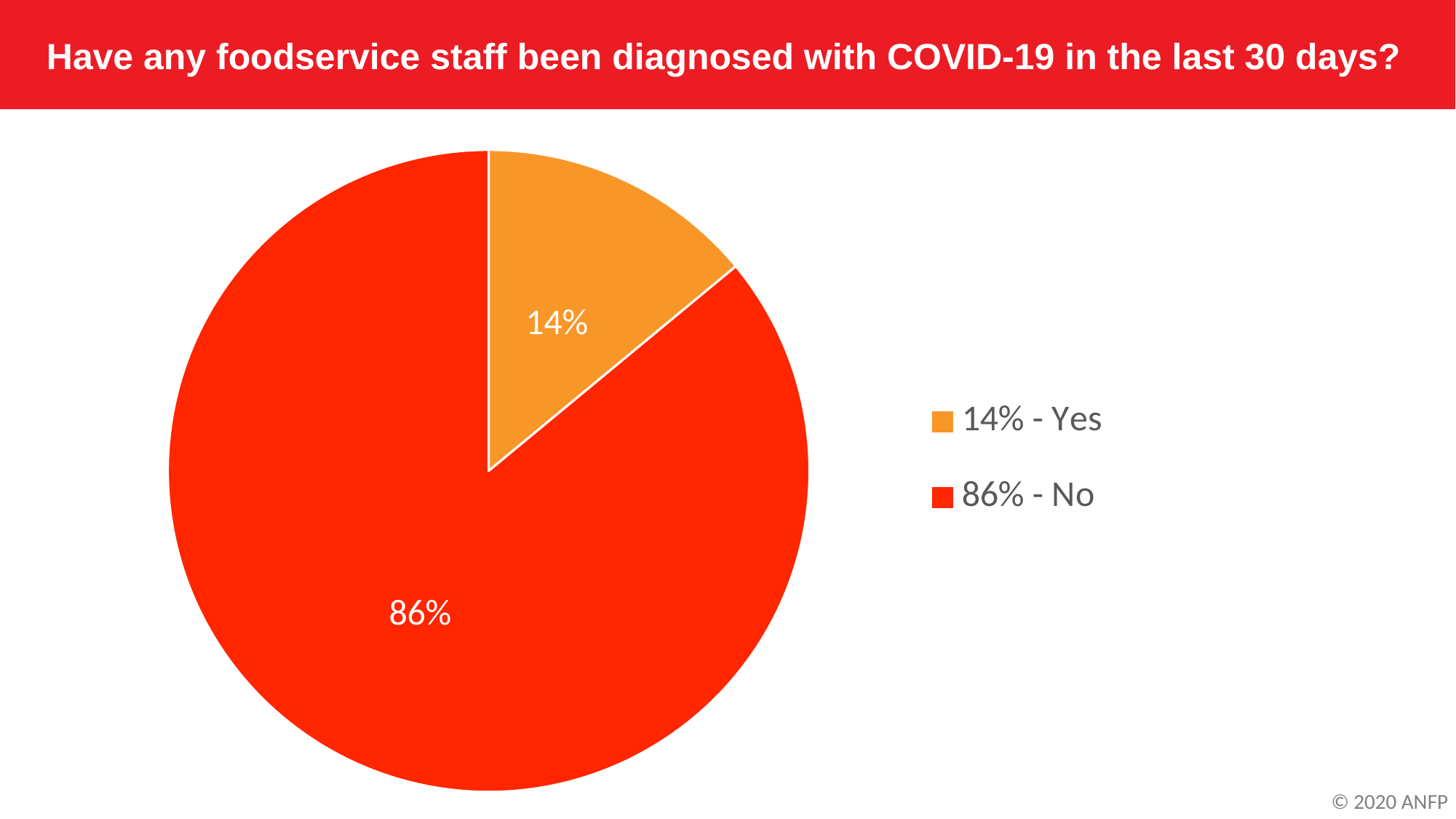
How many entries does the legend list? 2 What is the title of the chart? Have any foodservice staff been diagnosed with COVID-19 in the last 30 days? What share of the pie is labelled "No"? 86% What colour is the "Yes" slice of the pie? orange Which slice of the pie is the largest? No What is the total of the two slice percentages shown on the pie? 100% What share of the pie is labelled "Yes"? 14% Which is larger, the "Yes" slice or the "No" slice? No Which slice of the pie is the smallest? Yes How many slices does the pie chart have? 2 What kind of chart is shown on the slide? pie chart What is the difference in percentage points between the "No" and "Yes" slices? 72